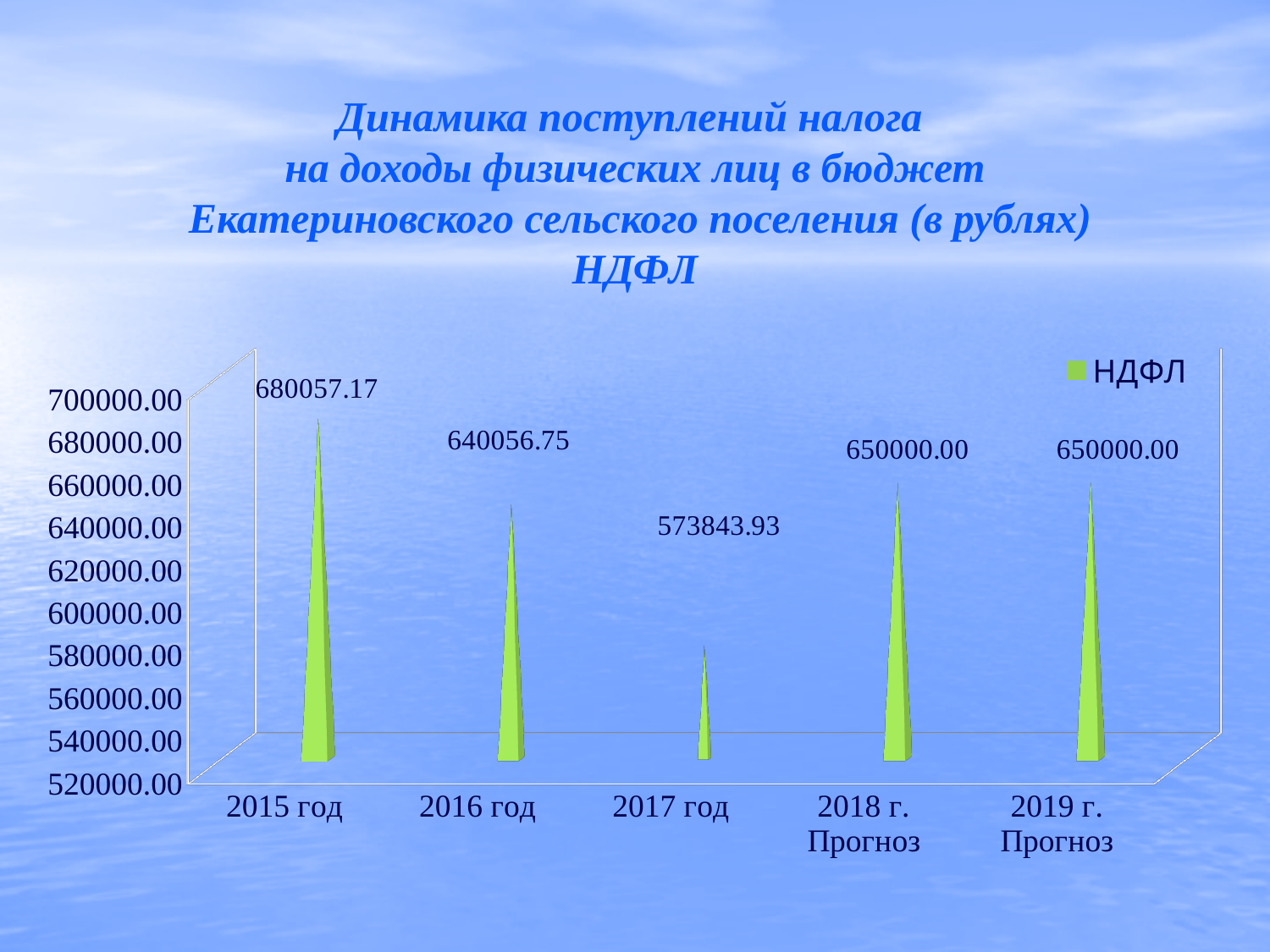
What kind of chart is shown? bar chart What is the difference between the values for 2018 г. Прогноз and 2017 год? 76156.07 What is the value for 2017 год? 573843.93 Which is larger, the value for 2016 год or the value for 2018 г. Прогноз? 2018 г. Прогноз What is the name of the series in the legend? НДФЛ What is the value for 2015 год? 680057.17 How many series does the legend list? 1 Which category has the highest value? 2015 год What is the value for 2018 г. Прогноз? 650000.00 What is the difference between the values for 2015 год and 2016 год? 40000.42 Which category has the lowest value? 2017 год How many categories are shown on the x axis? 5